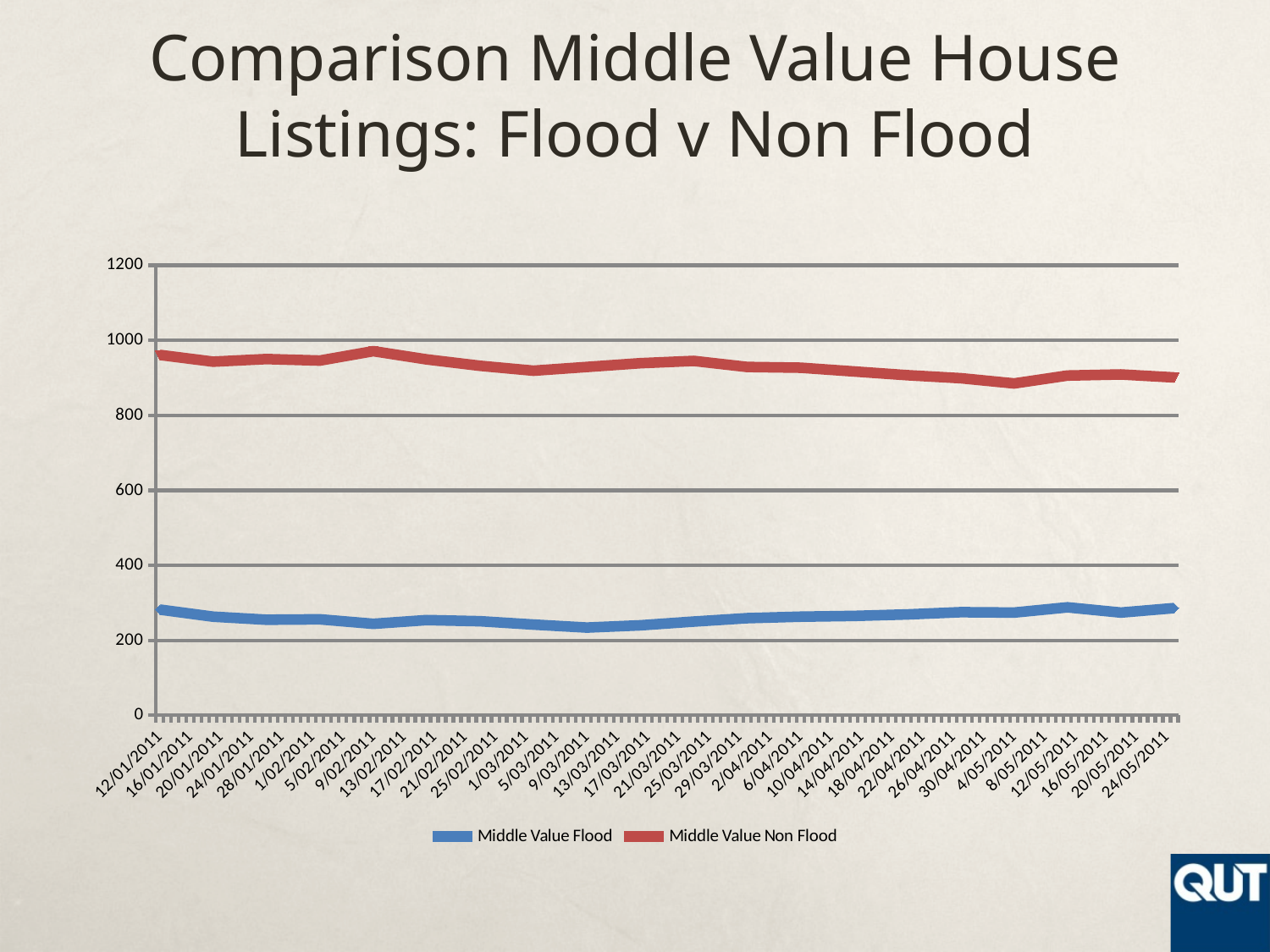
Is the value for Middle Value Flood on 9/03/2011 greater or less than 200? greater Does the Middle Value Non Flood line overall rise or fall from 12/01/2011 to 24/05/2011? fall Is the value for Middle Value Non Flood on 12/01/2011 greater or less than 800? greater What are the two series named in the legend? Middle Value Flood and Middle Value Non Flood What is the highest value shown on the vertical axis? 1200 Is the value for Middle Value Non Flood on 9/02/2011 greater or less than 1000? less What kind of chart is shown on the slide? line chart How many series does the legend list? 2 Which series has the higher values throughout the period, Middle Value Flood or Middle Value Non Flood? Middle Value Non Flood What is the title of the chart on the slide? Comparison Middle Value House Listings: Flood v Non Flood